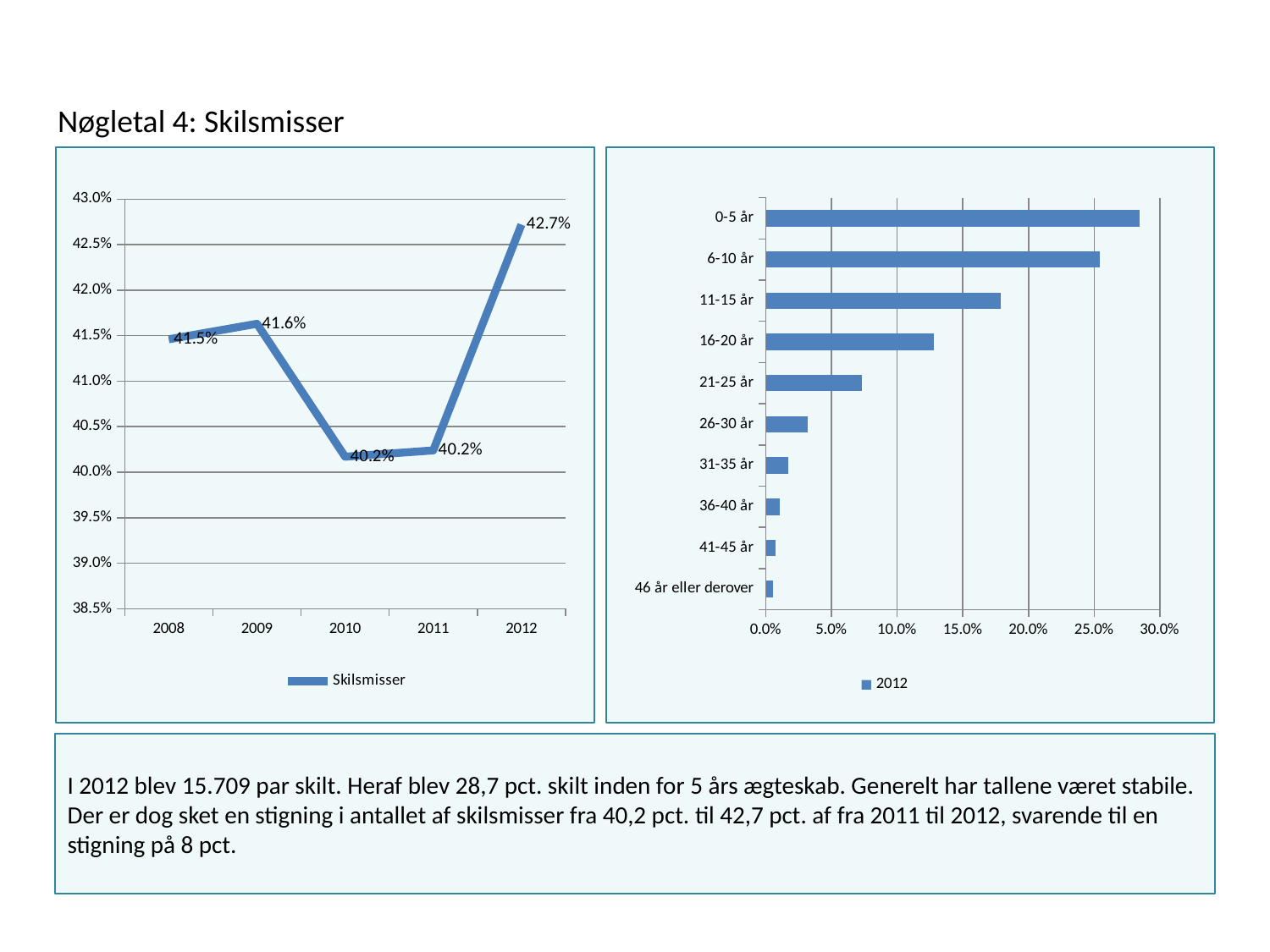
On the left chart, what is the value for 2012? 42.7% On the left chart, what is the difference between the values for 2012 and 2011? 2.5% On the left chart, which is larger, the value for 2008 or the value for 2010? 2008 What kind of chart is the left chart? line chart On the right chart, is the value for 6-10 år greater or less than 20.0%? greater On the left chart, which year has the highest value? 2012 On the right chart, how many categories are shown? 10 On the left chart, what is the value for 2009? 41.6% On the right chart, which category has the highest value? 0-5 år On the right chart, is the value for 21-25 år greater or less than 10.0%? less On the left chart, how many years are plotted on the x axis? 5 On the left chart, what is the name of the series shown in the legend? Skilsmisser